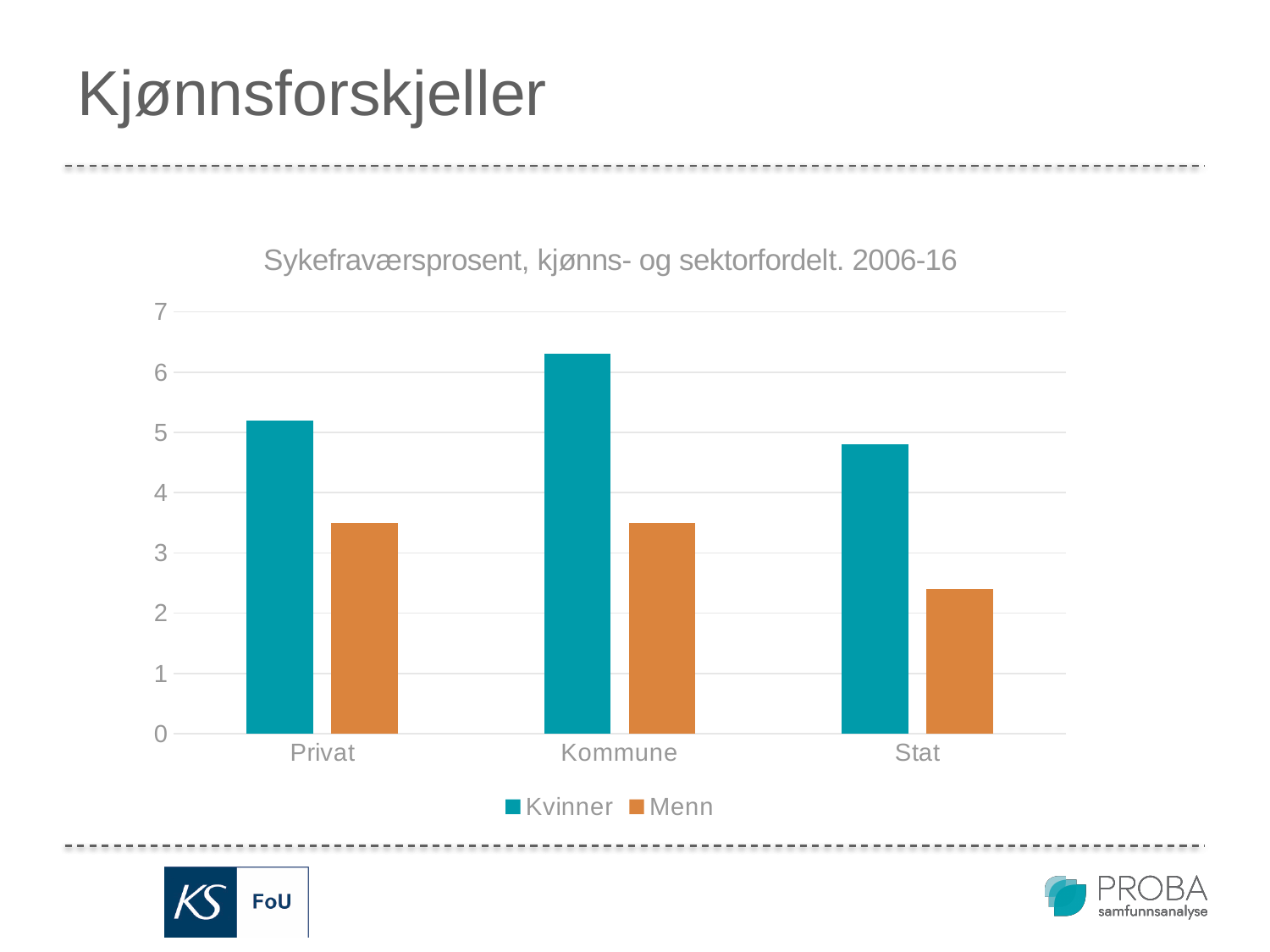
What kind of chart is shown on the slide? bar chart Which sector has the highest value for Kvinner? Kommune Which sector has the lowest value for Menn? Stat How many sector categories are shown on the x axis? 3 Is the value for Menn in Privat greater or less than 3? greater Is the value for Kvinner in Kommune greater or less than 6? greater Which sector has the lowest value for Kvinner? Stat Is the value for Menn in Stat greater or less than 3? less What is the title of the chart? Sykefraværsprosent, kjønns- og sektorfordelt. 2006-16 In the Stat sector, which is larger, the value for Kvinner or the value for Menn? Kvinner How many series does the legend list? 2